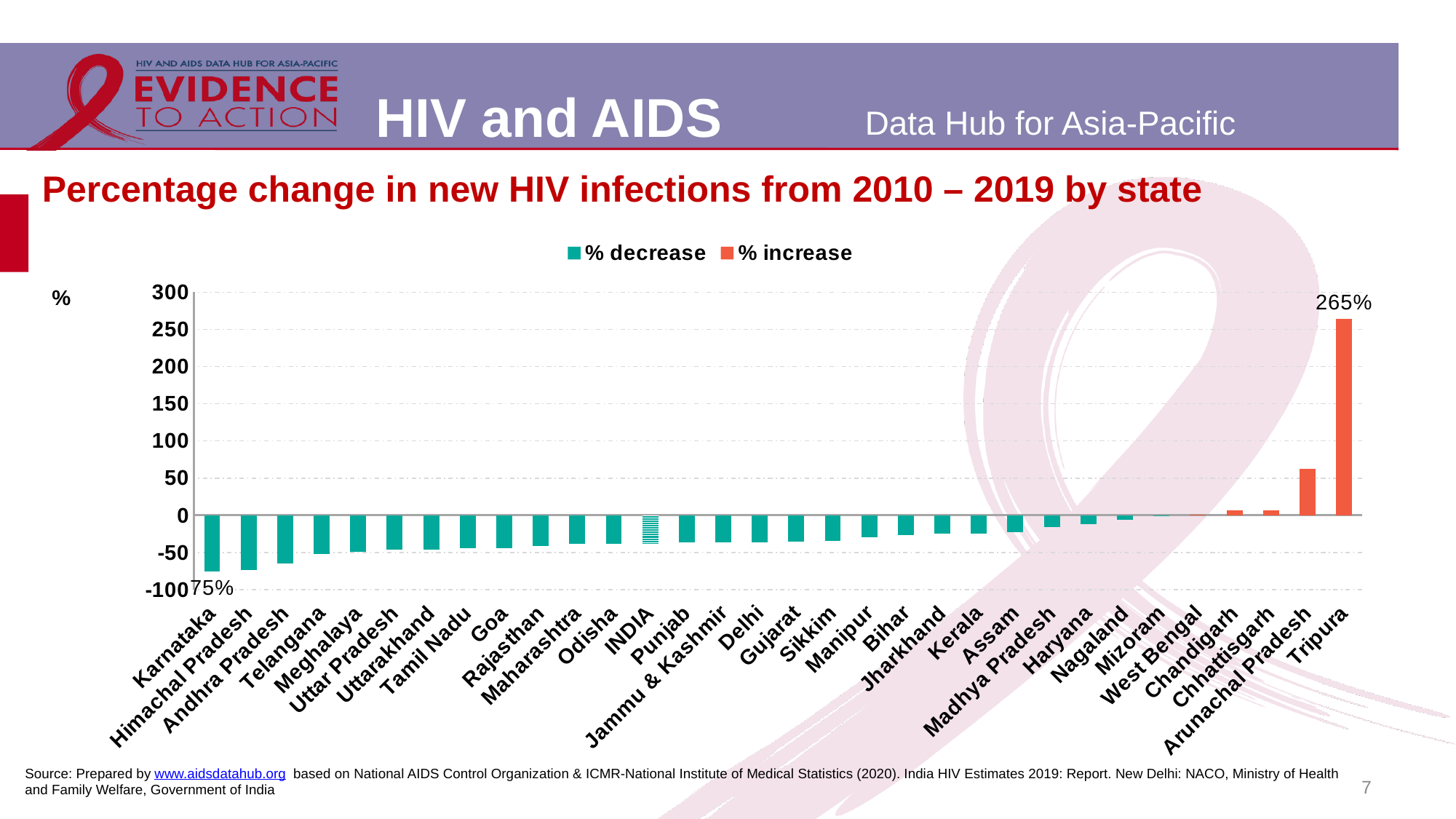
Is the value for Himachal Pradesh greater or less than -50? less Do the values generally rise or fall moving from left to right along the x axis? Rise What kind of chart is shown on the slide? Bar chart Which state has the lowest (largest decrease) percentage change in new HIV infections? Karnataka How many states/categories are plotted on the x axis? 32 How many series does the legend list? 2 Which is larger, the value for Tripura or the value for Arunachal Pradesh? Tripura Is the value for Arunachal Pradesh greater or less than 50? greater Which state has the highest percentage change in new HIV infections from 2010 to 2019? Tripura What colour represents the '% increase' series in the legend? Orange What is the percentage change in new HIV infections for Tripura? 265% Is the value for Chhattisgarh greater or less than 50? less